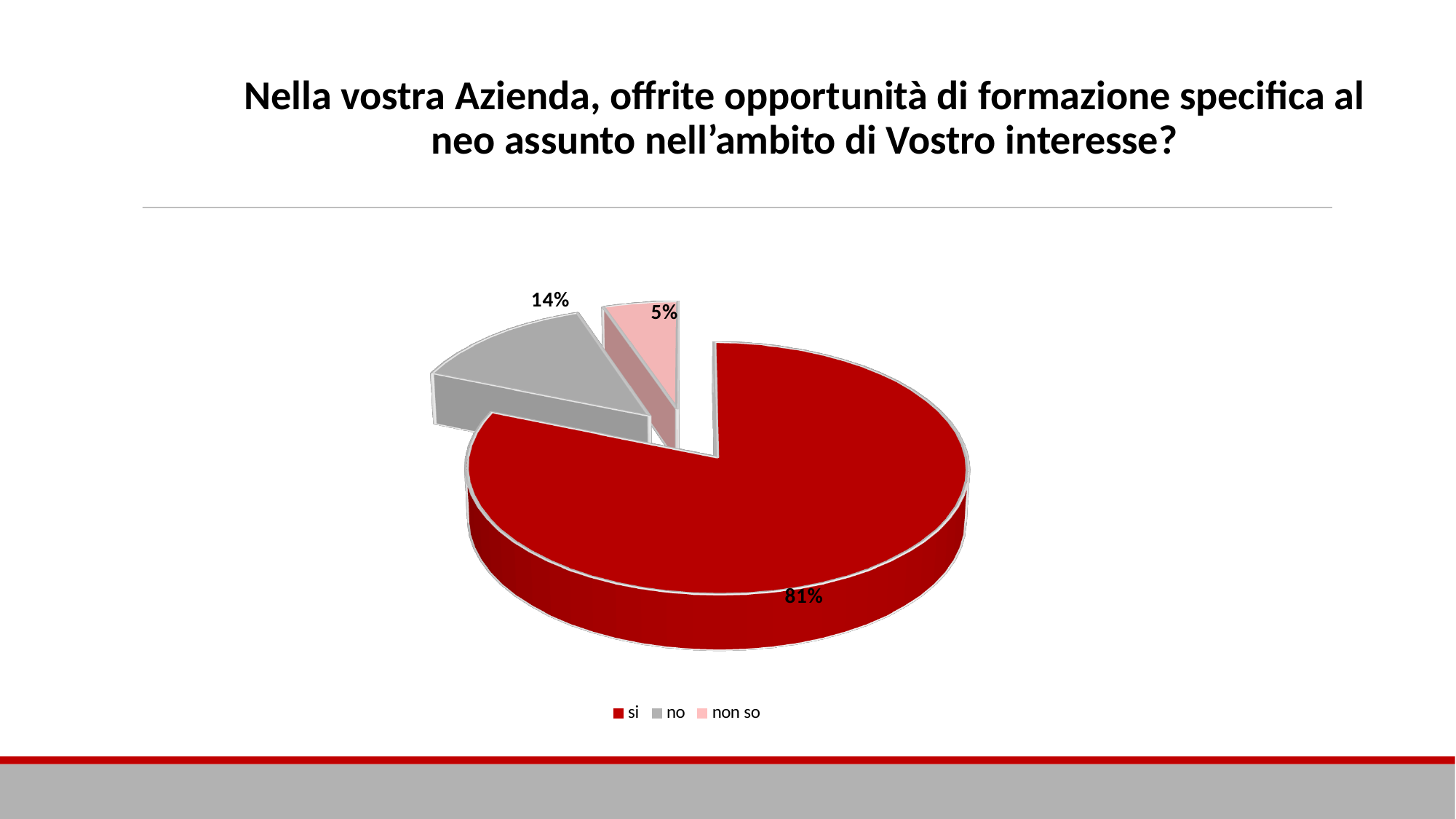
What kind of chart is shown on the slide? pie chart Which is larger, the share for "no" or the share for "non so"? no What percentage of respondents answered "non so"? 5% How many entries does the legend list? 3 Which response has the smallest share of the pie? non so How many slices does the pie chart have? 3 What is the difference in percentage points between "si" and "no"? 67 Which response has the largest share of the pie? si What percentage of respondents answered "no"? 14% What percentage of respondents answered "si"? 81% What colour is the slice for "si"? red What is the difference in percentage points between "no" and "non so"? 9